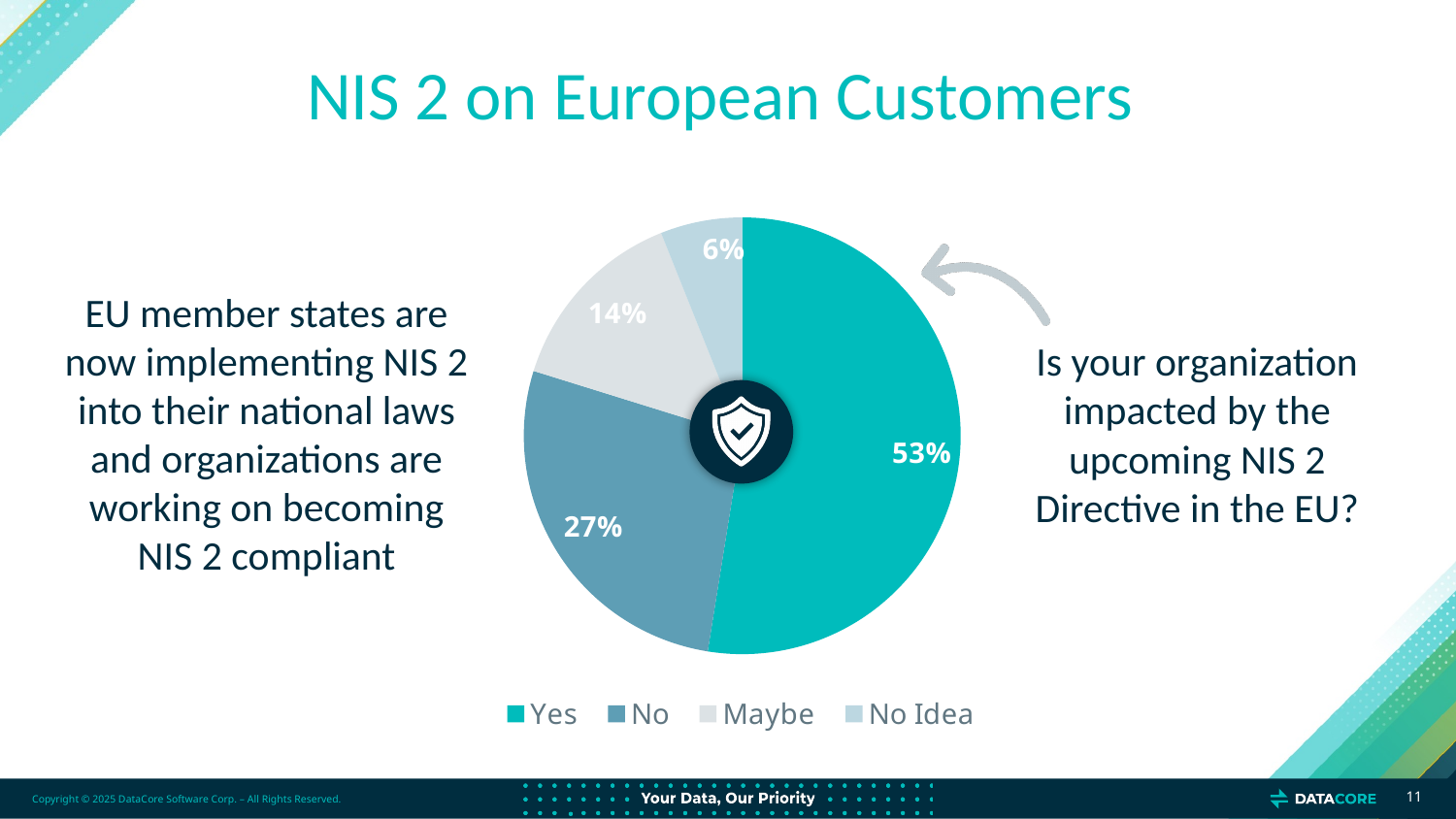
What percentage of respondents answered "Maybe"? 14% What is the difference in percentage points between the "Yes" and "No" slices? 26 Which response has the largest share of the pie? Yes Which slice is larger, "Maybe" or "No Idea"? Maybe How many entries does the legend list? 4 What question does the pie chart answer, according to the text to its right? Is your organization impacted by the upcoming NIS 2 Directive in the EU? Which response has the smallest share of the pie? No Idea What percentage of respondents answered "Yes"? 53% What percentage of respondents answered "No"? 27% How many slices does the pie chart have? 4 What kind of chart is shown on the slide? pie chart What percentage of respondents answered "No Idea"? 6%